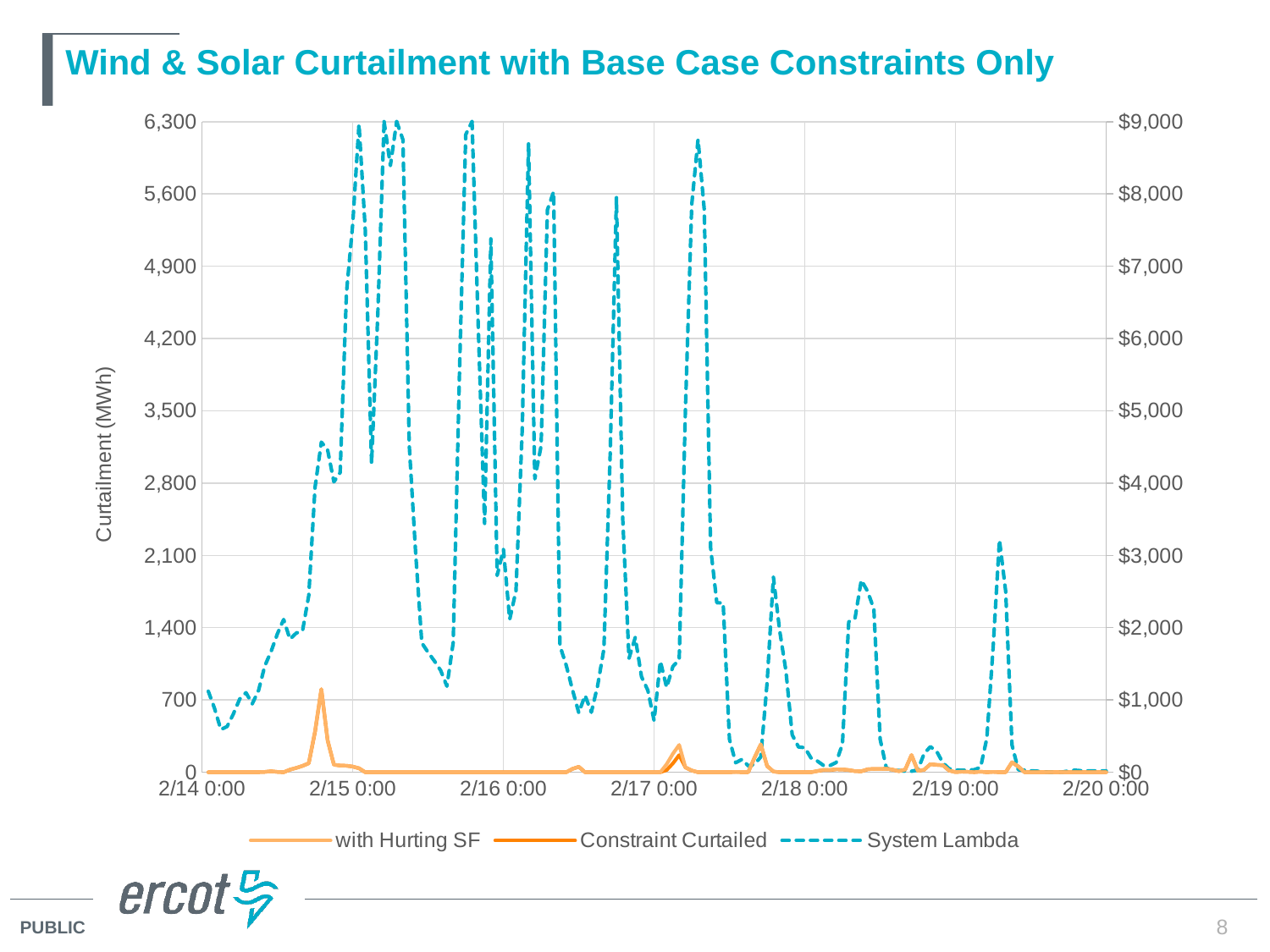
How many series does the legend list? 3 Is the System Lambda peak just before 2/18 0:00 greater or less than $3,000? less What is the title of the chart? Wind & Solar Curtailment with Base Case Constraints Only How many date labels are shown along the x axis? 7 Does System Lambda generally rise or fall between 2/17 0:00 and 2/20 0:00? fall Is the highest value of System Lambda greater or less than $8,000? greater Is the System Lambda peak after 2/19 0:00 greater or less than $4,000? less What kind of chart is shown on the slide? line chart What is the label of the left vertical axis? Curtailment (MWh)